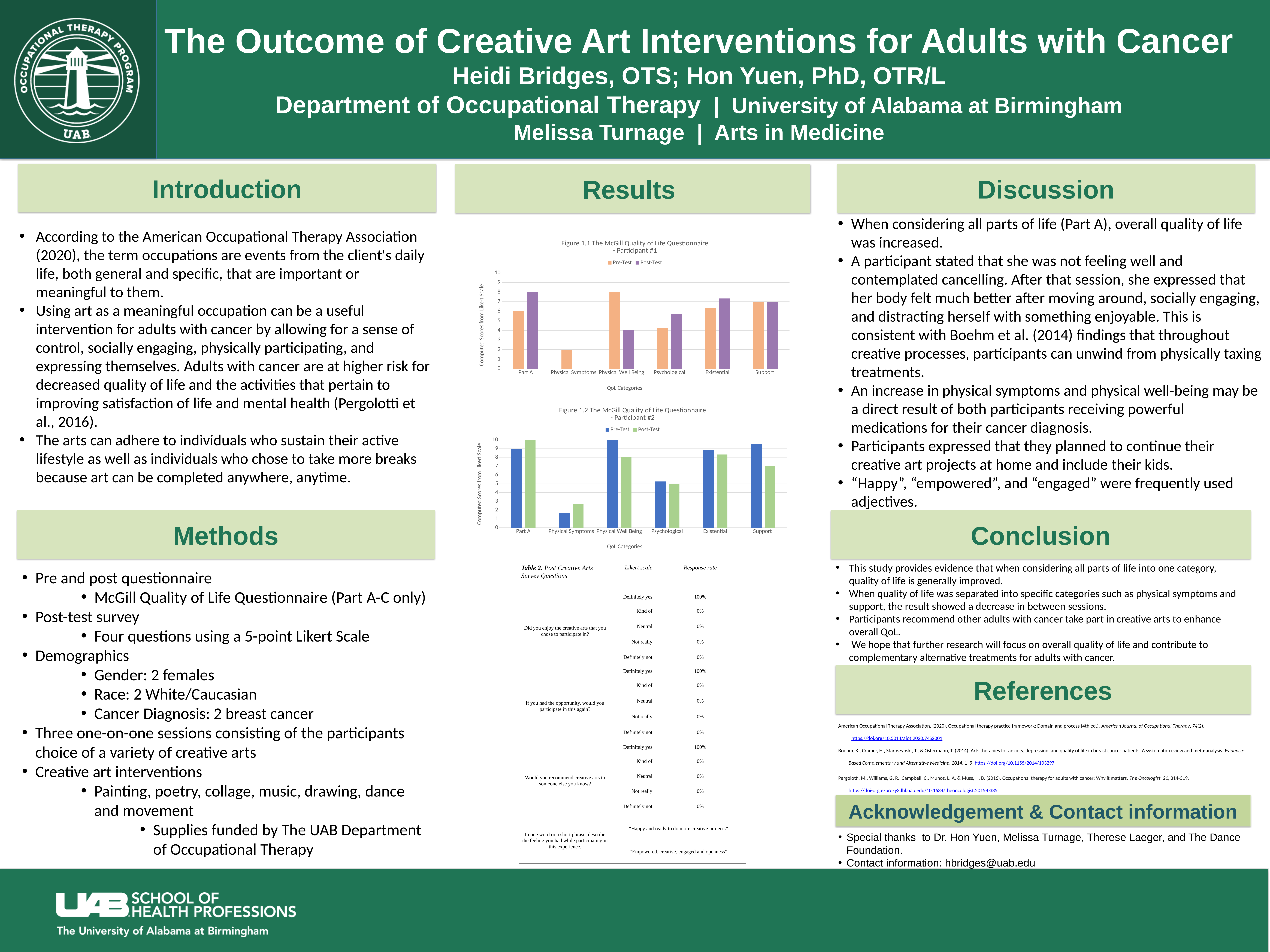
In Figure 1.2 The McGill Quality of Life Questionnaire - Participant #2, is the Pre-Test score for Physical Symptoms greater or less than 3? less In Figure 1.2 The McGill Quality of Life Questionnaire - Participant #2, which is larger for Support, the Pre-Test or the Post-Test score? Pre-Test In Figure 1.1 The McGill Quality of Life Questionnaire - Participant #1, is the Post-Test score for Physical Well Being greater or less than 5? less How many QoL categories are shown on the x axis of Figure 1.2 The McGill Quality of Life Questionnaire - Participant #2? 6 What is the y-axis label of Figure 1.2 The McGill Quality of Life Questionnaire - Participant #2? Computed Scores from Likert Scale In Figure 1.1 The McGill Quality of Life Questionnaire - Participant #1, which QoL category has the highest Pre-Test score? Physical Well Being In Figure 1.2 The McGill Quality of Life Questionnaire - Participant #2, which QoL category has the lowest Post-Test score? Physical Symptoms In Figure 1.1 The McGill Quality of Life Questionnaire - Participant #1, which is larger for Part A, the Pre-Test or the Post-Test score? Post-Test In Figure 1.1 The McGill Quality of Life Questionnaire - Participant #1, is the Post-Test score for Part A greater or less than 7? greater In Figure 1.1 The McGill Quality of Life Questionnaire - Participant #1, which QoL category has the lowest Pre-Test score? Physical Symptoms How many series does the legend of Figure 1.1 The McGill Quality of Life Questionnaire - Participant #1 list? 2 What kind of chart is Figure 1.1 The McGill Quality of Life Questionnaire - Participant #1? bar chart